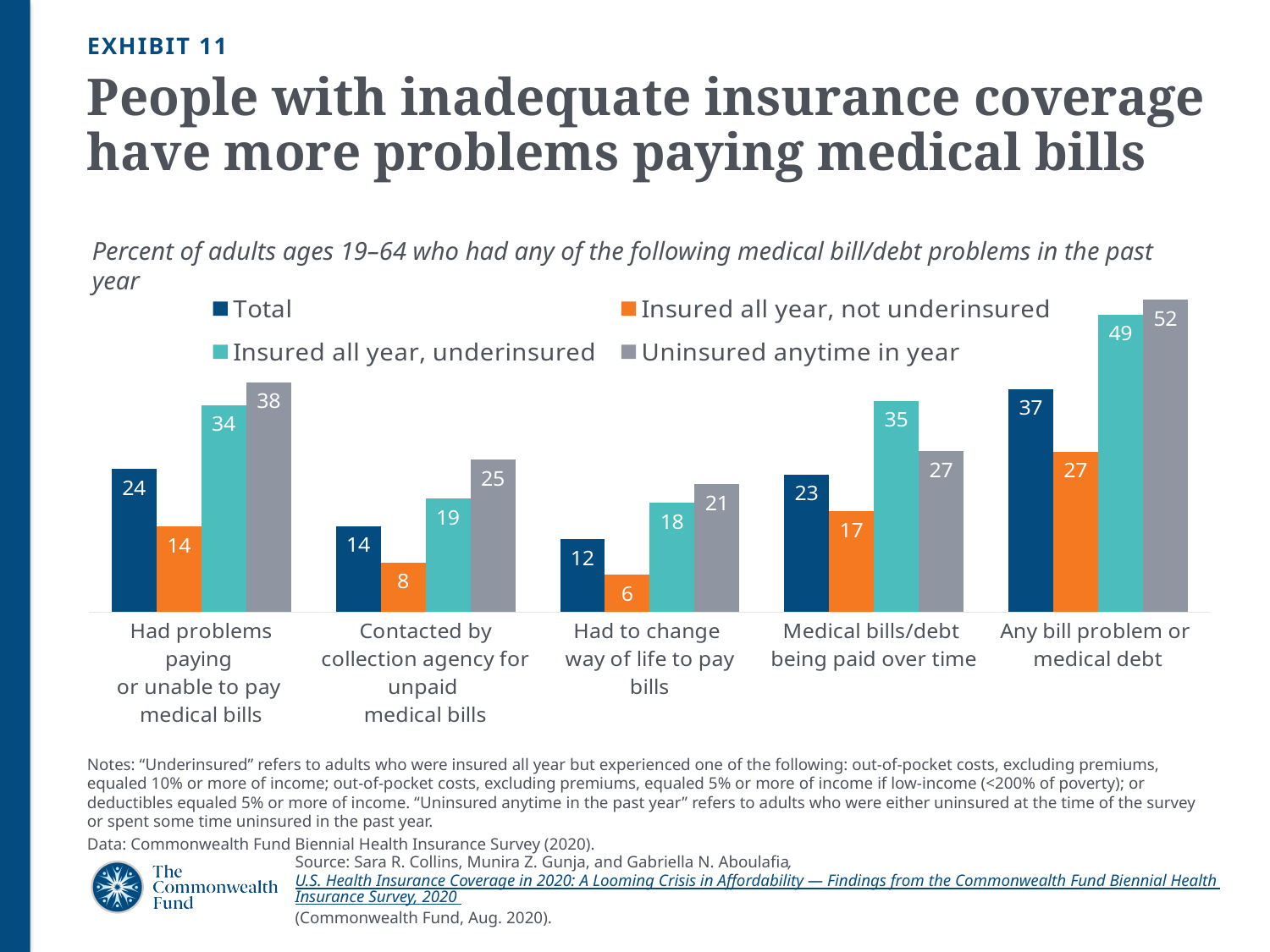
What is the value for 'Insured all year, not underinsured' in the 'Had to change way of life to pay bills' category? 6 How many categories are shown on the x axis? 5 What is the value for Total in the 'Had problems paying or unable to pay medical bills' category? 24 What kind of chart is shown on the slide? Bar chart What is the value for 'Uninsured anytime in year' in the 'Any bill problem or medical debt' category? 52 What is the value for 'Insured all year, underinsured' in the 'Medical bills/debt being paid over time' category? 35 Which series is shown in orange in the legend? Insured all year, not underinsured Which category has the highest value for the 'Uninsured anytime in year' series? Any bill problem or medical debt What is the difference between the 'Uninsured anytime in year' and 'Insured all year, not underinsured' values in the 'Contacted by collection agency for unpaid medical bills' category? 17 Which category has the lowest value for the Total series? Had to change way of life to pay bills How many series does the legend list? 4 In the 'Any bill problem or medical debt' category, which is larger: the Total value or the 'Insured all year, not underinsured' value? Total